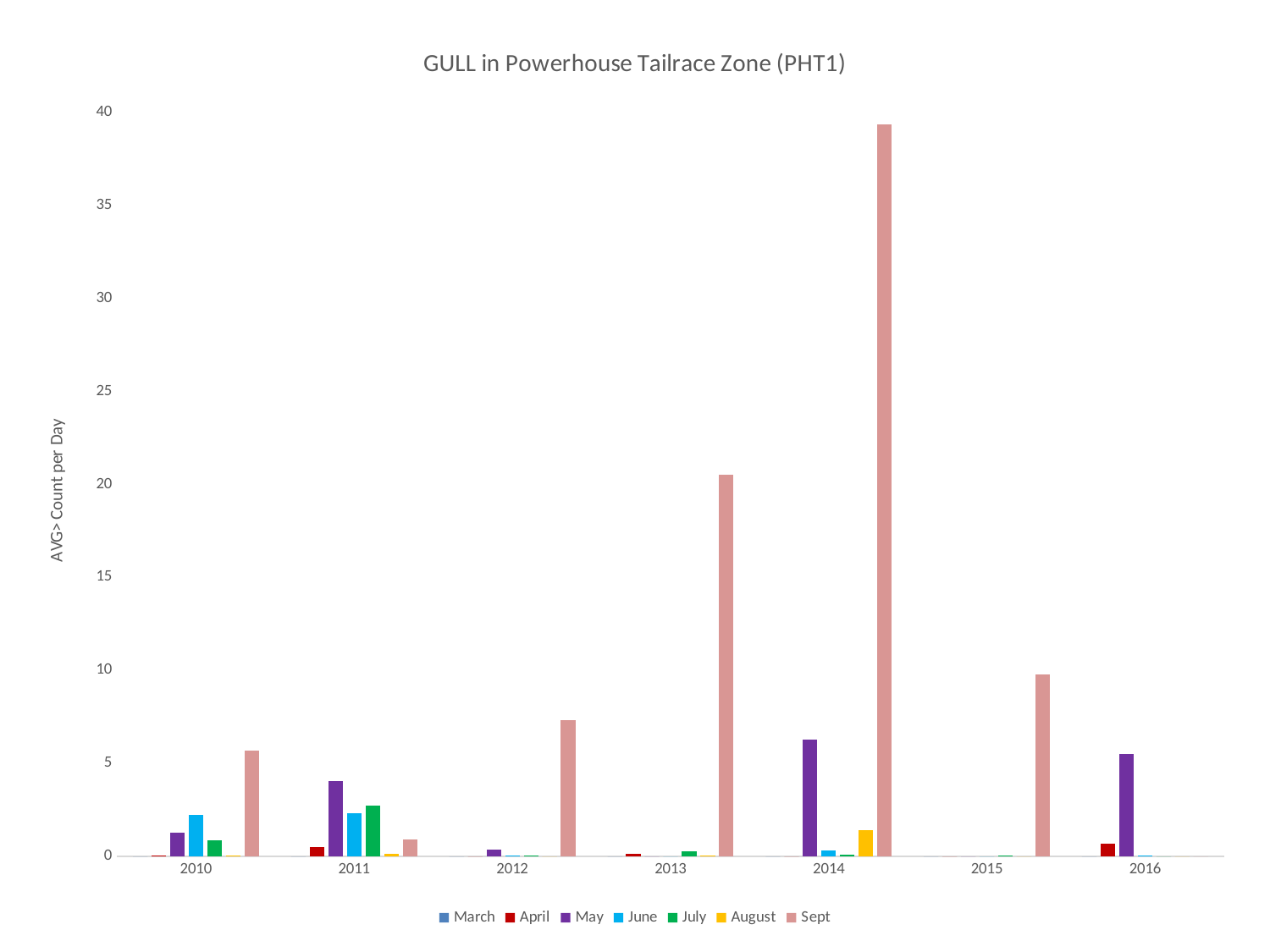
Is the Sept value for 2015 greater or less than 5? greater What is the title of the chart? GULL in Powerhouse Tailrace Zone (PHT1) How many years are shown on the x axis? 7 Do the Sept values rise or fall from 2012 to 2014? rise Which year has the highest Sept value? 2014 Is the Sept value for 2014 greater or less than 35? greater Is the Sept value for 2013 greater or less than 15? greater What kind of chart is shown on the slide? bar chart How many series does the legend list? 7 Which is larger, the Sept value for 2010 or the Sept value for 2012? 2012 Which is larger, the May value for 2011 or the May value for 2014? 2014